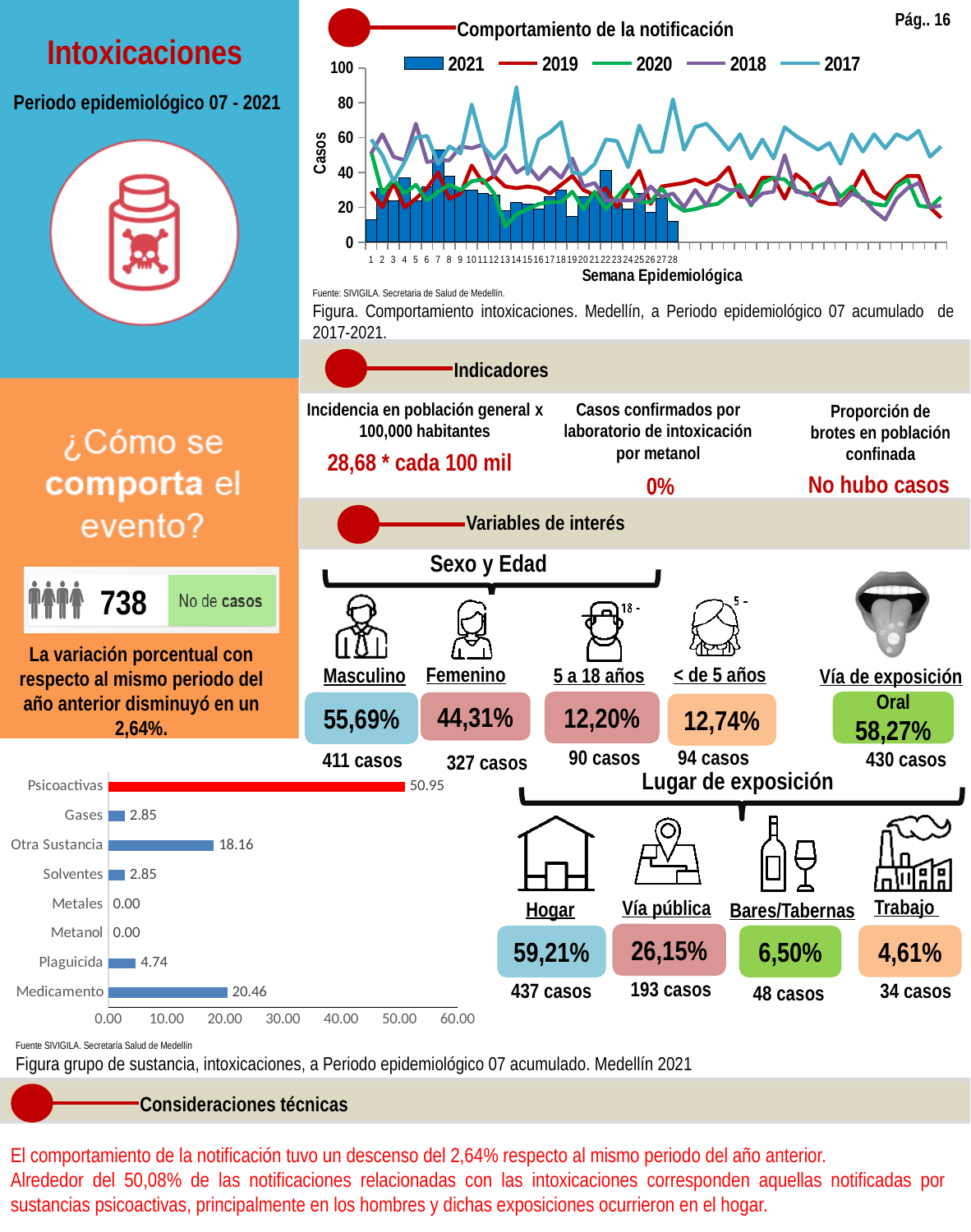
In the bottom-left bar chart (grupo de sustancia), what is the difference between the values for Psicoactivas and Medicamento? 30.49 In the bottom-left bar chart (grupo de sustancia), what is the value for Medicamento? 20.46 In the top chart 'Comportamiento de la notificación', is the value for 2021 at week 1 greater or less than 20? less In the bottom-left bar chart (grupo de sustancia), what is the value for Metanol? 0.00 In the bottom-left bar chart (grupo de sustancia), what is the value for Psicoactivas? 50.95 In the bottom-left bar chart (grupo de sustancia), what is the value for Plaguicida? 4.74 In the bottom-left bar chart (grupo de sustancia), how many categories are shown? 8 In the top chart 'Comportamiento de la notificación', is the value for 2017 at week 14 greater or less than 80? greater In the top chart 'Comportamiento de la notificación', how many series does the legend list? 5 In the bottom-left bar chart (grupo de sustancia), which is larger, the value for Medicamento or the value for Otra Sustancia? Medicamento In the bottom-left bar chart (grupo de sustancia), which category has the highest value? Psicoactivas What kind of chart is the bottom-left chart (grupo de sustancia)? Bar chart